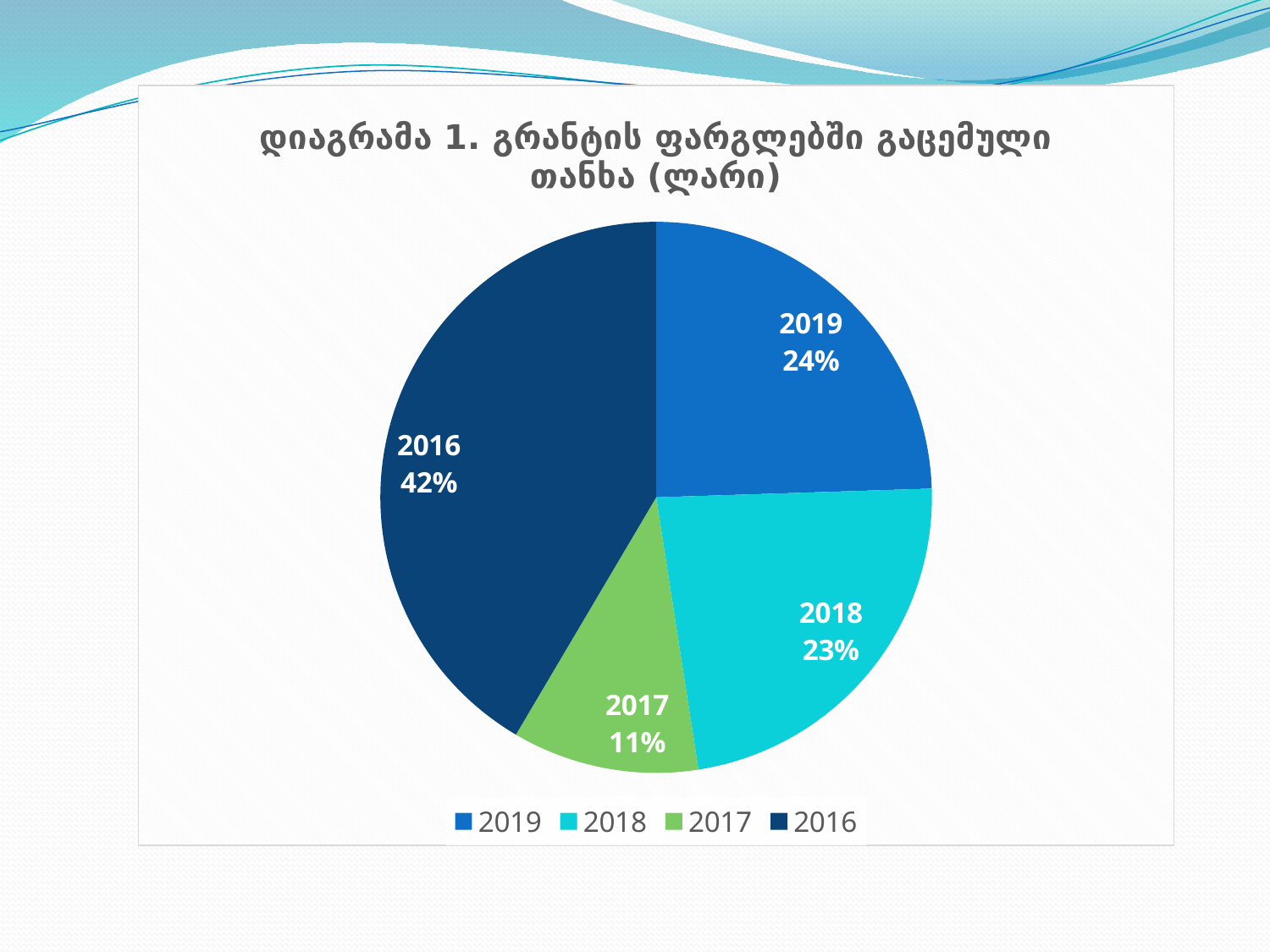
What kind of chart is shown on the slide? pie chart Which slice is larger, 2016 or 2019? 2016 What is the difference in percentage points between the 2016 slice and the 2017 slice? 31 What is the difference in percentage points between the 2019 slice and the 2018 slice? 1 What share of the pie does 2016 represent? 42% What share of the pie does 2019 represent? 24% Which year has the smallest slice of the pie? 2017 What share of the pie does 2017 represent? 11% How many entries does the legend list? 4 Which year has the largest slice of the pie? 2016 How many slices does the pie chart have? 4